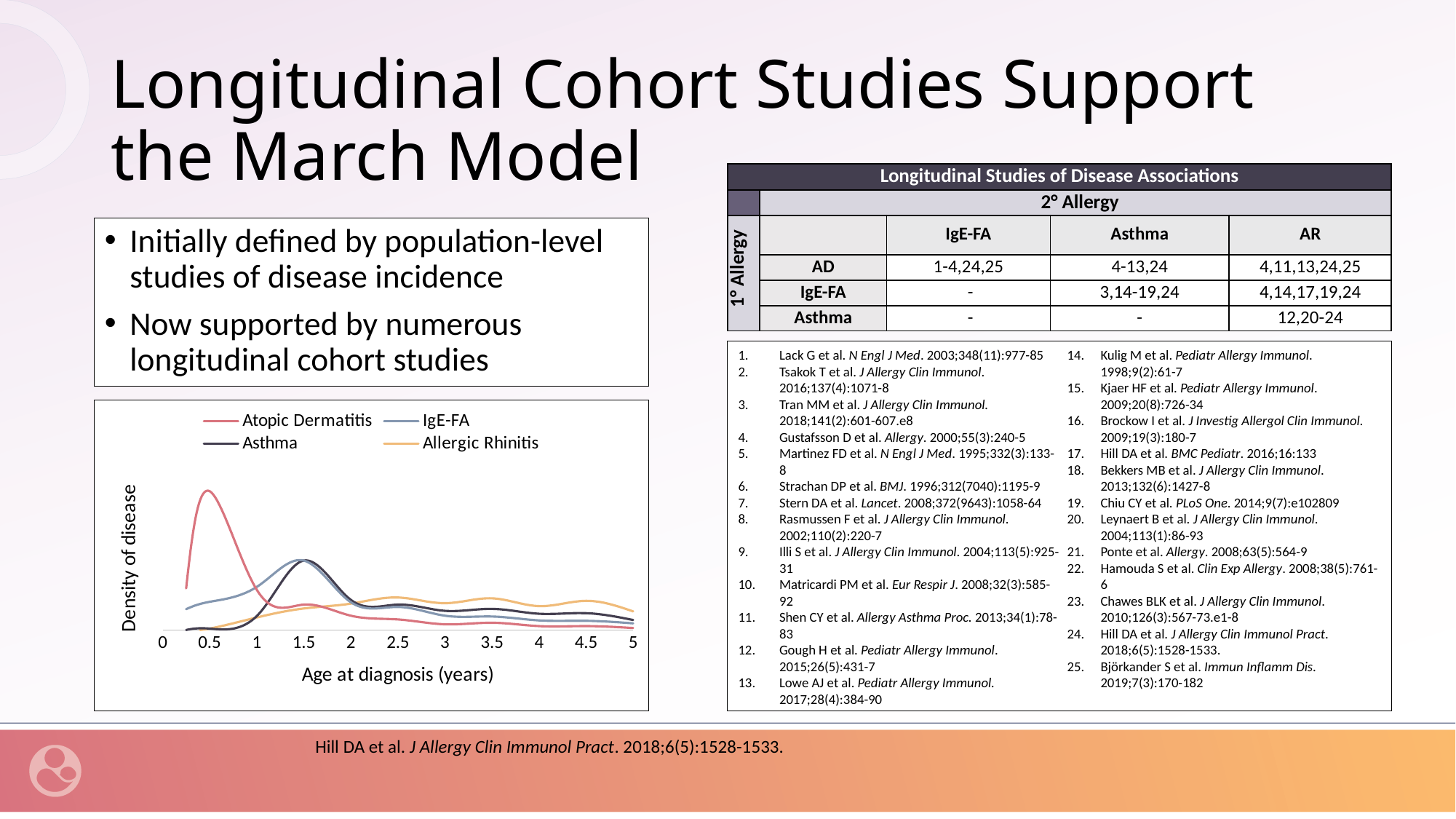
Which series has the lowest density at age 5 years? Atopic Dermatitis What is the label of the chart's y axis? Density of disease Does the Asthma curve rise or fall between ages 1 and 1.5 years? Rise How many series does the chart's legend list? 4 Which series has a higher peak: Asthma or Allergic Rhinitis? Asthma How many tick labels are shown on the chart's x axis? 11 Does the Atopic Dermatitis curve rise or fall between ages 0.5 and 2 years? Fall What is the label of the chart's x axis? Age at diagnosis (years) What kind of chart is shown on the slide? Line chart Which series has the highest density at age 4.5 years? Allergic Rhinitis Which series in the chart reaches the highest peak density of disease? Atopic Dermatitis Which series peaks at the earliest age at diagnosis? Atopic Dermatitis